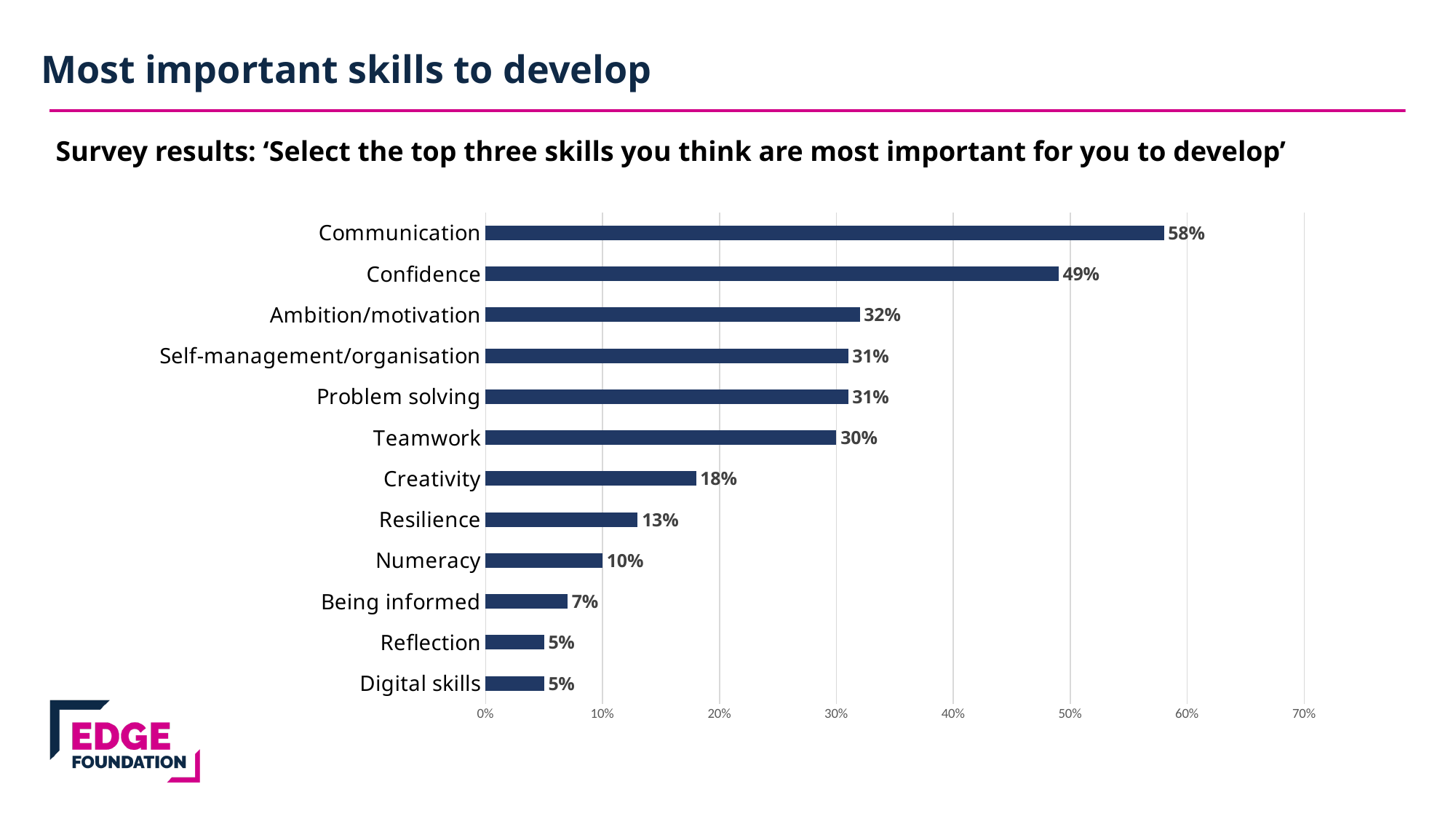
What percentage of respondents selected Communication as a top-three skill to develop? 58% What is the highest value labelled on the horizontal axis? 70% What is the difference in percentage points between Creativity and Numeracy? 8 What is the value shown for Resilience? 13% What is the value shown for Teamwork? 30% What is the difference in percentage points between Communication and Confidence? 9 How many skills are listed in the chart? 12 What type of chart is shown on the slide? Bar chart Which skill has the highest percentage? Communication Which has a higher value, Ambition/motivation or Teamwork? Ambition/motivation Which has a higher value, Resilience or Being informed? Resilience Is the value for Confidence greater or less than 40%? greater